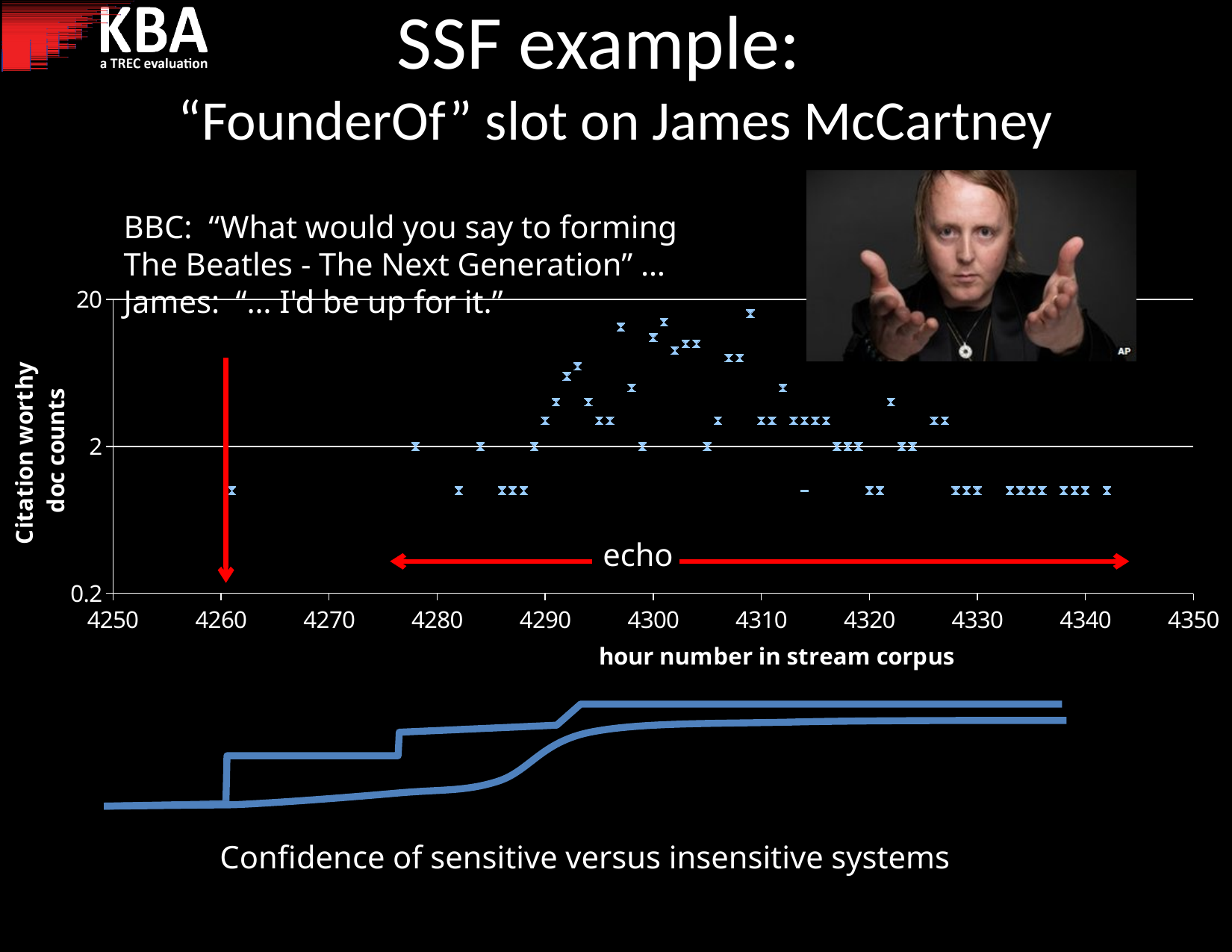
What kind of chart is the plot of citation worthy doc counts against hour number? scatter plot Is the value plotted at hour 4260 greater or less than 2? less Is the value plotted at hour 4309 greater or less than 2? greater What word labels the red double-headed arrow on the scatter plot? echo What is the title of the x axis of the scatter plot? hour number in stream corpus Is the value plotted at hour 4342 greater or less than 2? less